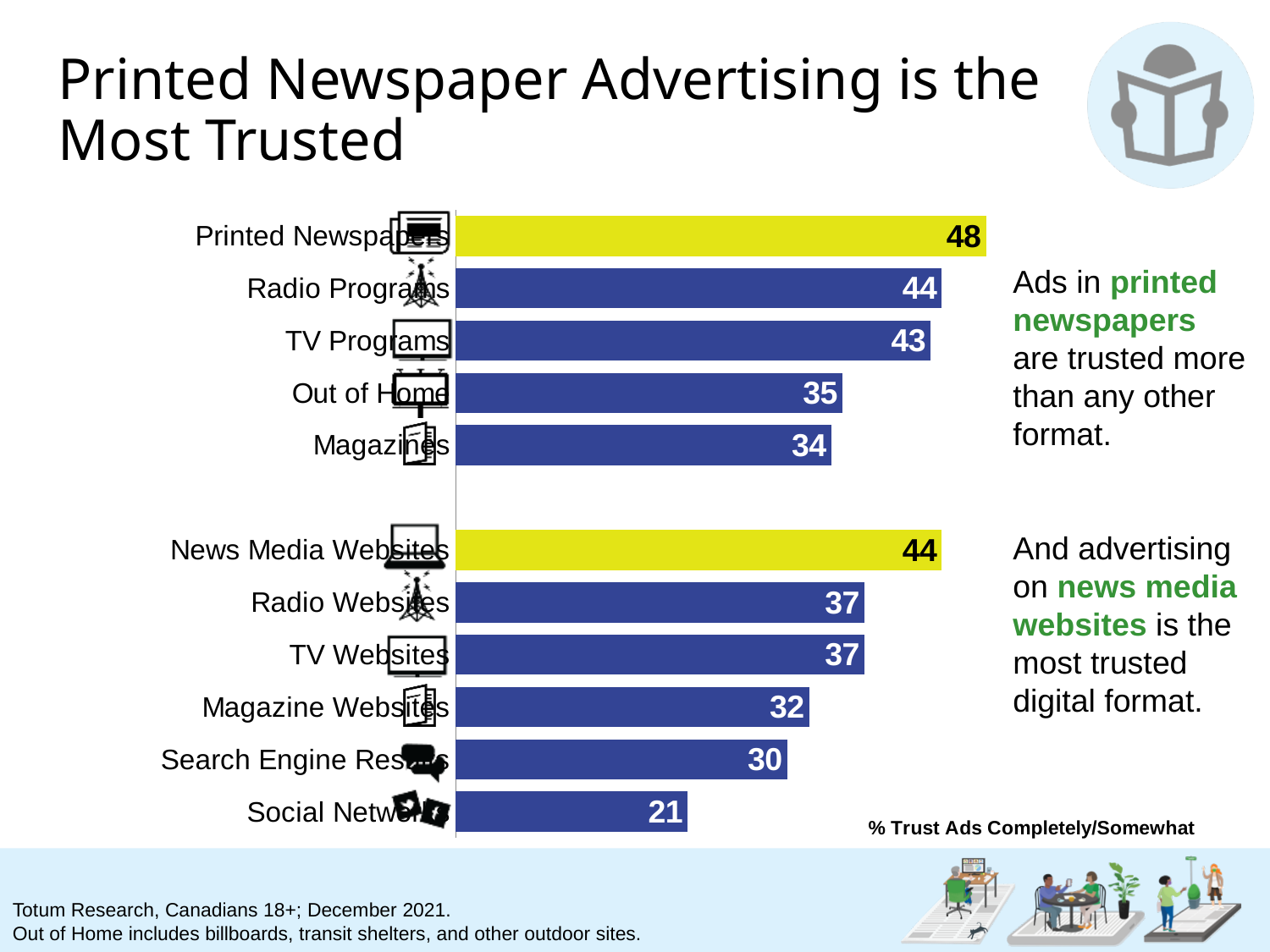
Which category has the lowest value? Social Networks What is the value for Out of Home? 35 Which category has the highest value? Printed Newspapers What is the value for News Media Websites? 44 What is the difference between the values for Radio Programs and Social Networks? 23 What does the label at the bottom right of the chart say the values represent? % Trust Ads Completely/Somewhat What kind of chart is shown on the slide? Bar chart Which is larger, the value for TV Programs or the value for Magazine Websites? TV Programs What is the value for Social Networks? 21 What is the value for Printed Newspapers? 48 What is the difference between the values for Printed Newspapers and News Media Websites? 4 How many categories are shown in the chart? 11